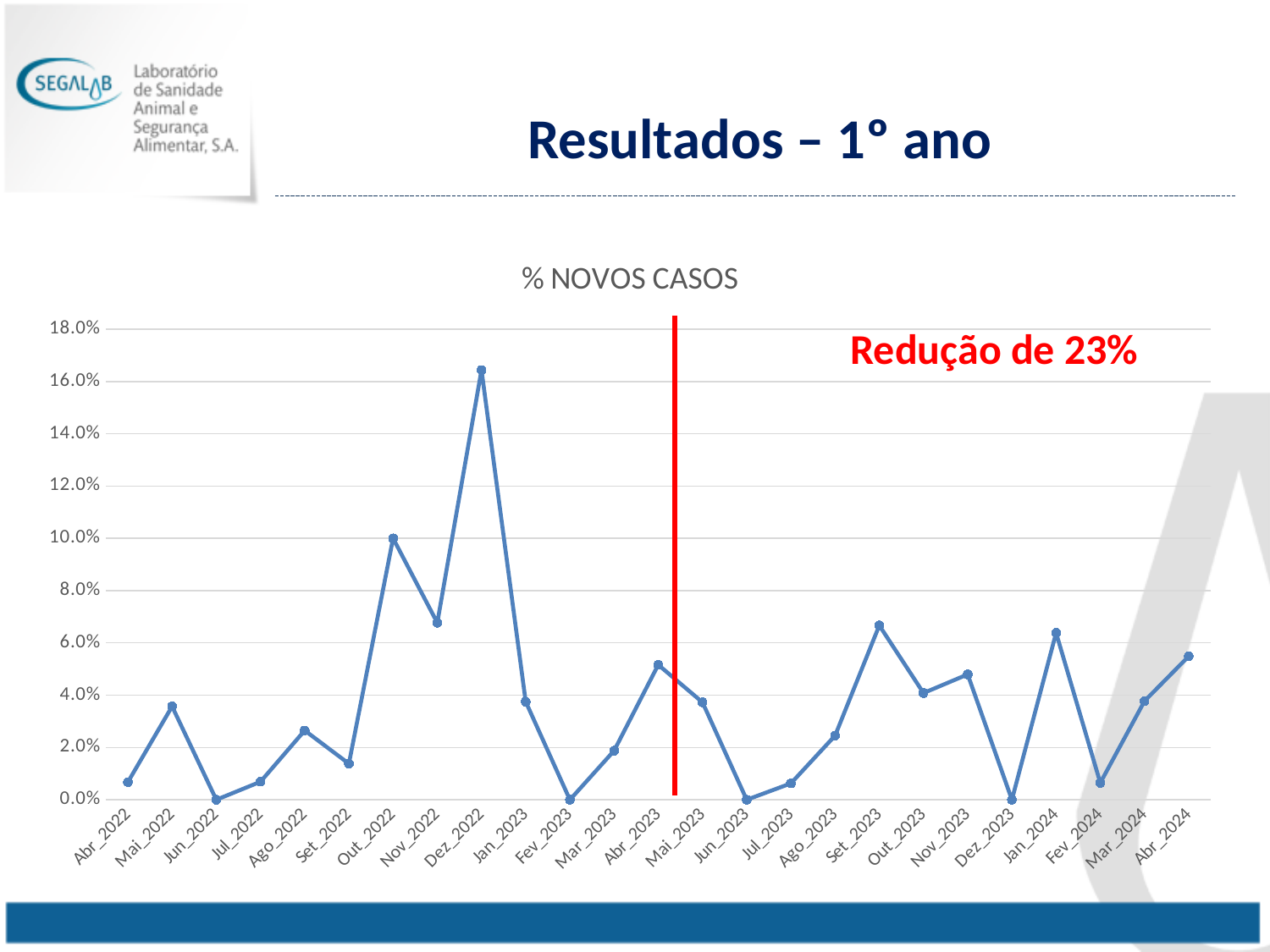
Is the value for Dez_2022 greater or less than 16.0%? greater Is the value for Set_2023 greater or less than 8.0%? less What is the title of the chart? % NOVOS CASOS Which month has the highest value in the chart? Dez_2022 What is the value for Out_2022? 10.0% Which is larger, the value for Set_2023 or the value for Ago_2023? Set_2023 Which is larger, the value for Dez_2022 or the value for Out_2022? Dez_2022 How many monthly data points are plotted in the chart? 25 What kind of chart is shown on the slide? line chart What reduction percentage is stated in the red annotation on the chart? Redução de 23% What is the value for Jun_2022? 0.0% What is the value for Dez_2023? 0.0%